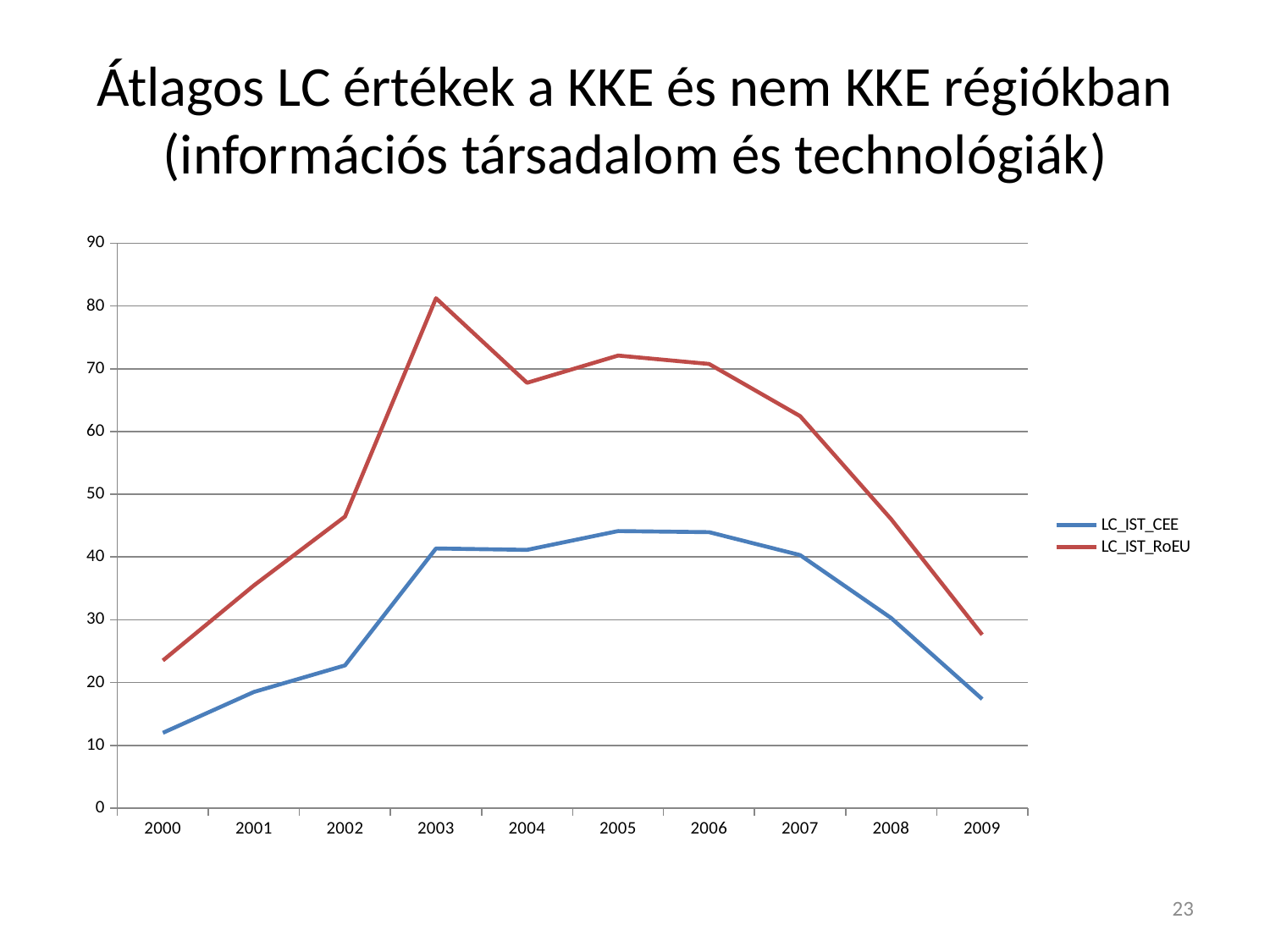
What colour is the LC_IST_RoEU line? red Is the value for LC_IST_RoEU in 2009 greater or less than 30? less In which year is LC_IST_RoEU at its lowest value? 2000 In which year does LC_IST_RoEU reach its highest value? 2003 Does LC_IST_RoEU rise or fall from 2006 to 2009? fall What kind of chart is shown on the slide? line chart How many years are shown on the x axis? 10 Is the value for LC_IST_RoEU in 2003 greater or less than 70? greater Is the value for LC_IST_CEE in 2000 greater or less than 20? less How many series does the legend list? 2 Which series has the larger value in 2004, LC_IST_CEE or LC_IST_RoEU? LC_IST_RoEU In which year is LC_IST_CEE at its lowest value? 2000